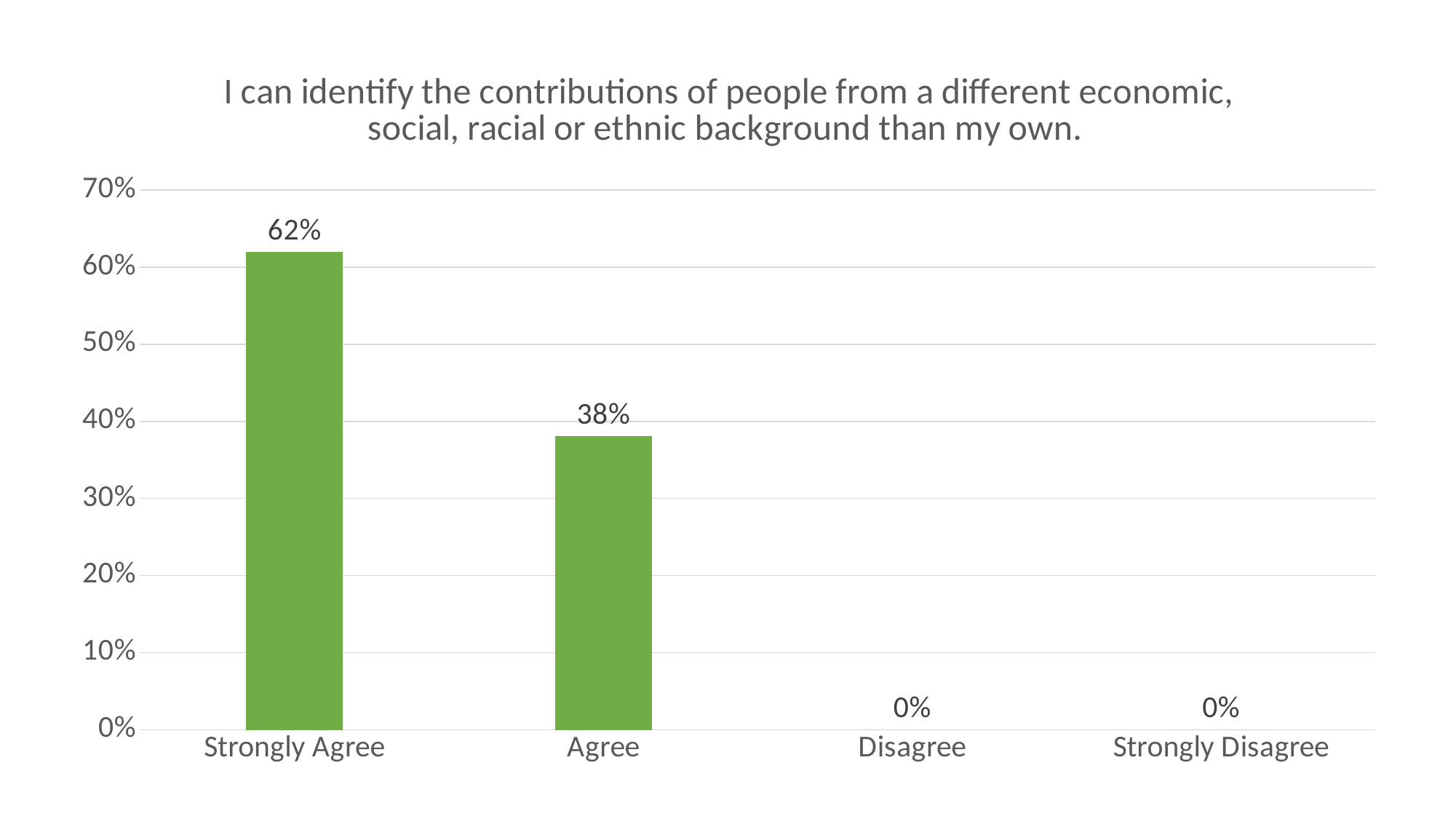
What is the difference between the Strongly Agree and Agree percentages? 24% What percentage of respondents chose Agree? 38% Is the value for Strongly Agree greater or less than 60%? greater What percentage of respondents chose Disagree? 0% What kind of chart is shown on the slide? Bar chart What percentage of respondents chose Strongly Agree? 62% Is the value for Agree greater or less than 40%? less What percentage of respondents chose Strongly Disagree? 0% How many response categories are shown on the x axis? 4 What is the title of the chart? I can identify the contributions of people from a different economic, social, racial or ethnic background than my own. Which response category has the highest value? Strongly Agree Which is larger, the value for Strongly Agree or the value for Agree? Strongly Agree